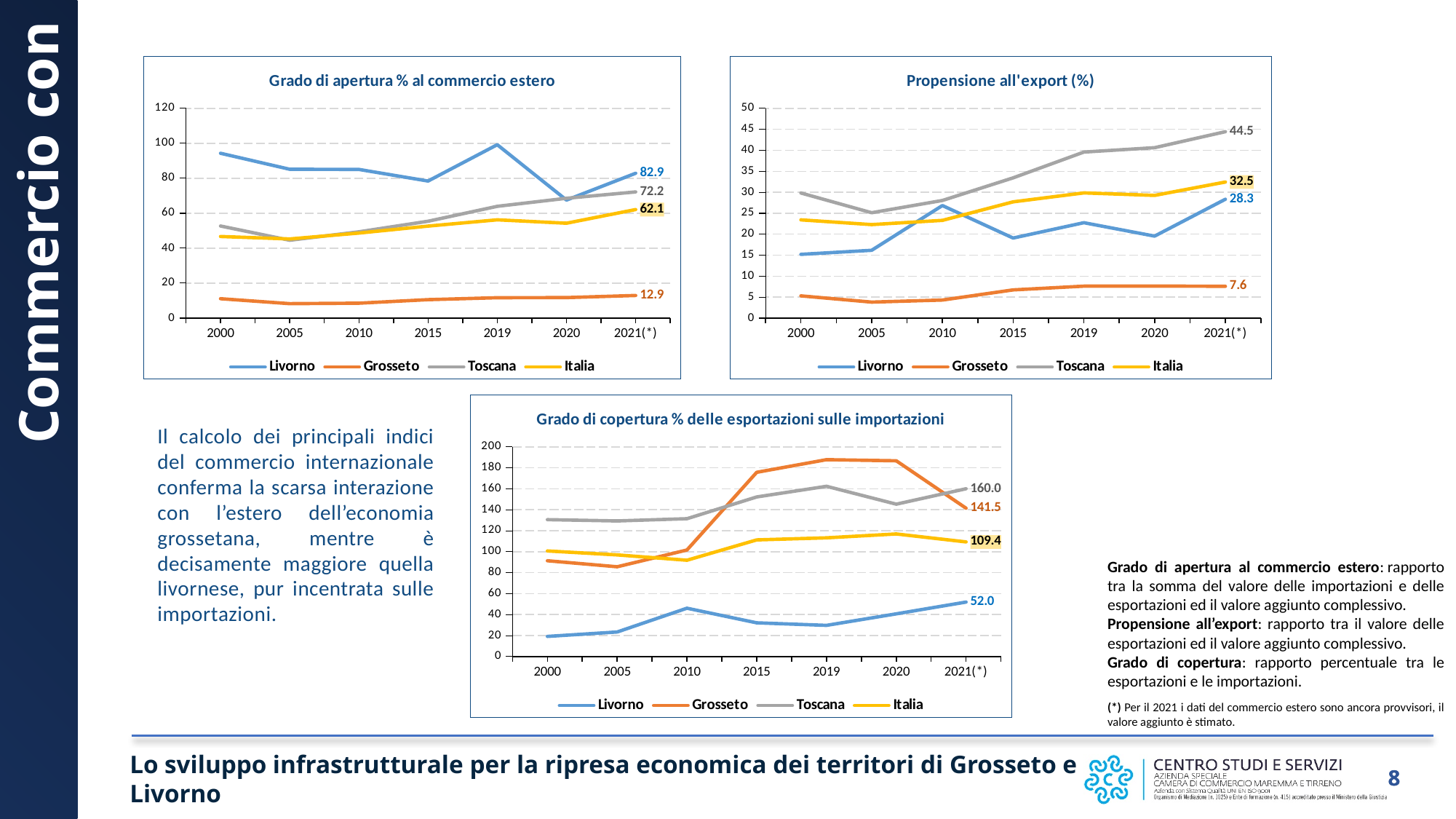
In the chart 'Grado di apertura % al commercio estero', what is the value for Grosseto in 2021(*)? 12.9 In the chart 'Propensione all'export (%)', is the value for Livorno in 2000 greater or less than 20? less In the chart 'Grado di copertura % delle esportazioni sulle importazioni', what is the value for Grosseto in 2021(*)? 141.5 In the chart 'Propensione all'export (%)', what is the value for Italia in 2021(*)? 32.5 In the chart 'Grado di apertura % al commercio estero', what is the value for Livorno in 2021(*)? 82.9 In the chart 'Grado di apertura % al commercio estero', what is the difference between the 2021(*) values for Toscana and Italia? 10.1 In the chart 'Grado di copertura % delle esportazioni sulle importazioni', which is larger in 2021(*): Toscana or Italia? Toscana How many series does the legend of the chart 'Propensione all'export (%)' list? 4 What kind of chart is 'Grado di copertura % delle esportazioni sulle importazioni'? Line chart In the chart 'Grado di copertura % delle esportazioni sulle importazioni', which series has the lowest value in 2021(*)? Livorno How many points along the x axis does the chart 'Grado di apertura % al commercio estero' show? 7 In the chart 'Propensione all'export (%)', which series has the highest value in 2021(*)? Toscana